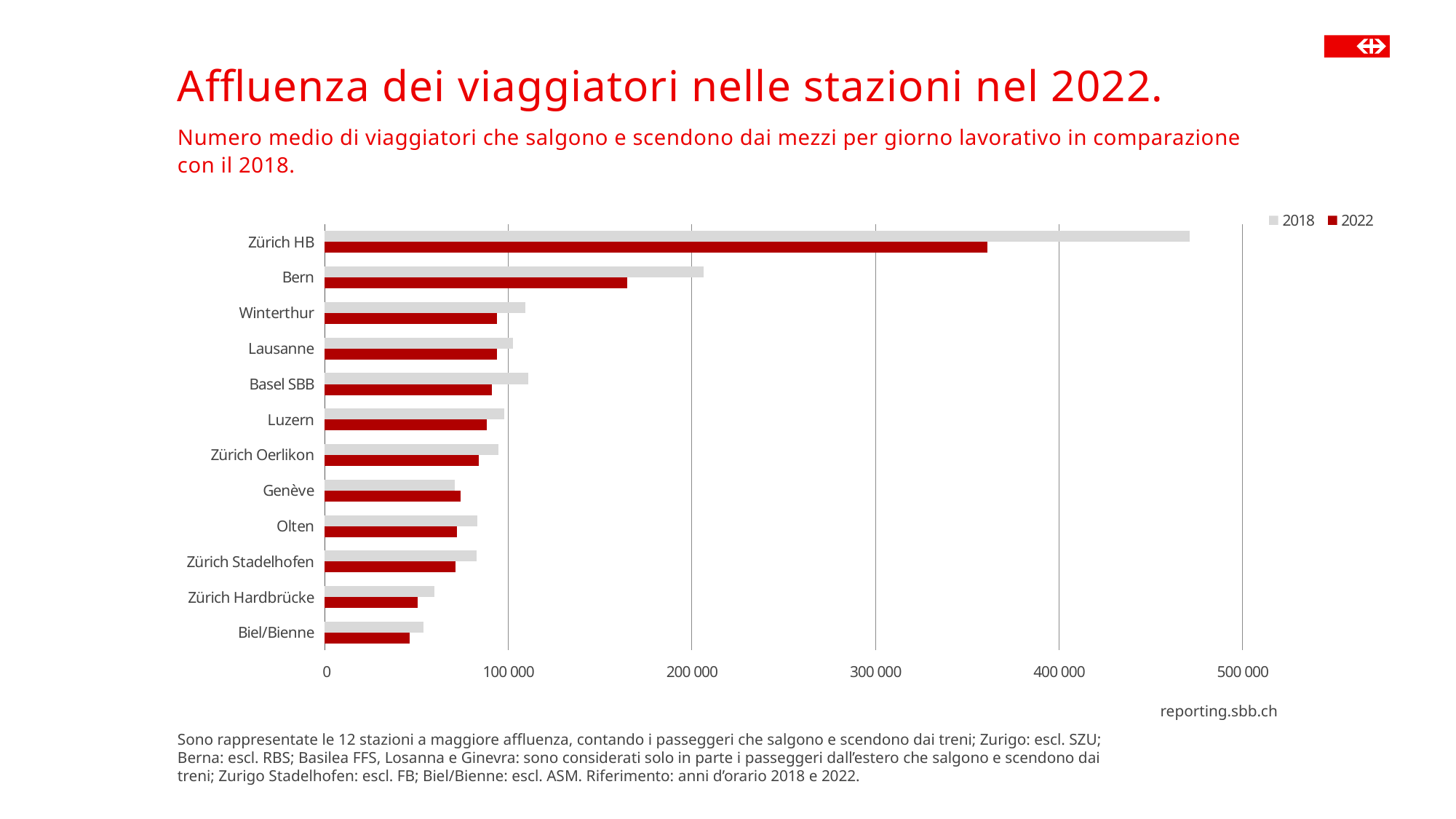
What kind of chart is shown on the slide? bar chart Is the 2018 value for Zürich HB greater or less than 500 000? less Is the 2022 value for Zürich HB greater or less than 300 000? greater For Zürich HB, which is larger: the 2018 value or the 2022 value? 2018 Which colour represents the 2022 series in the chart? red Which station has the highest value in 2022? Zürich HB Is the 2022 value for Biel/Bienne greater or less than 100 000? less How many series does the legend list? 2 How many stations are shown in the chart? 12 Which has the larger 2022 value: Bern or Winterthur? Bern Which station has the highest value in 2018? Zürich HB